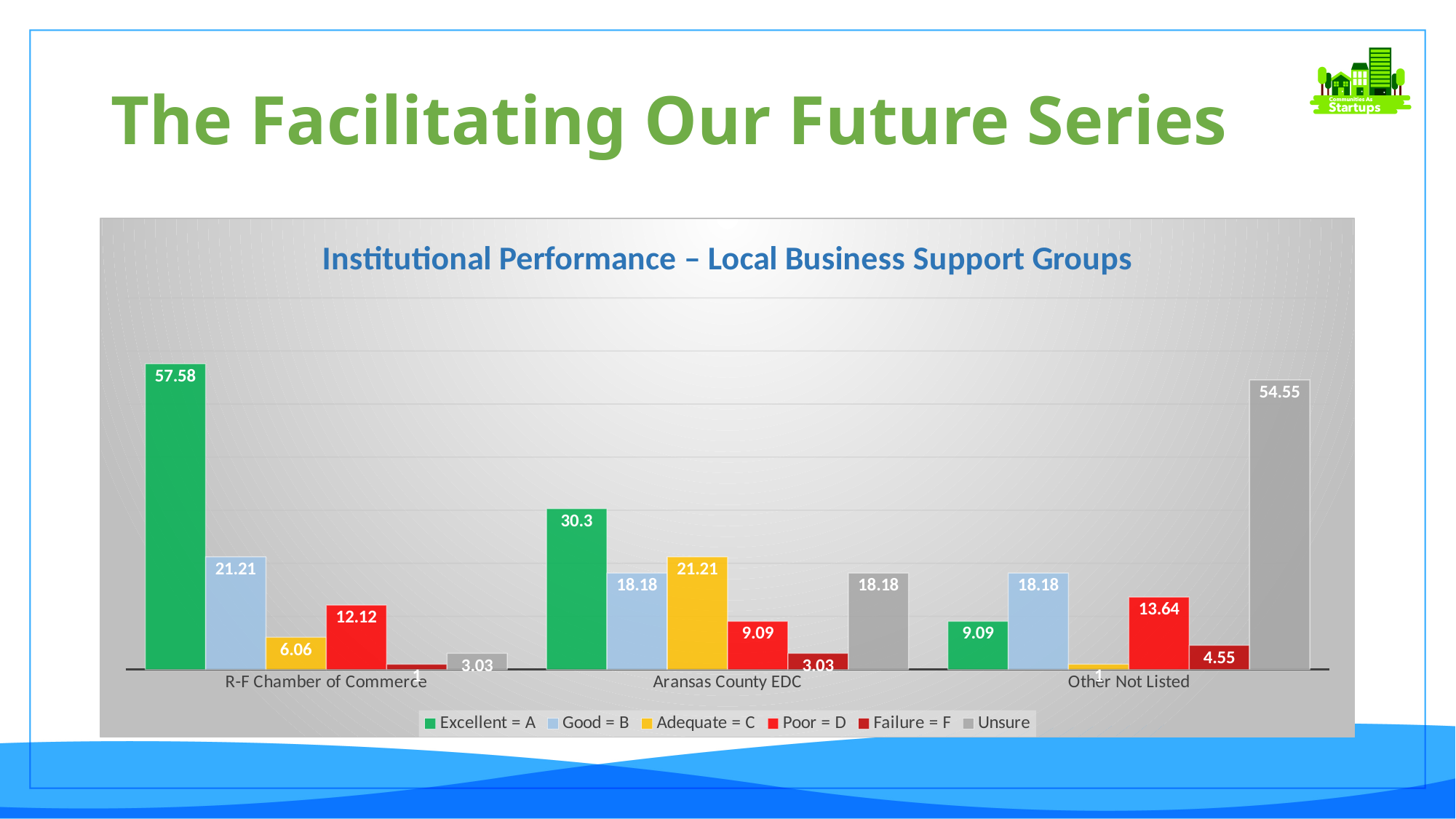
What is the difference between the Excellent = A values for R-F Chamber of Commerce and Aransas County EDC? 27.28 Which is larger for Aransas County EDC: Good = B or Adequate = C? Adequate = C How many categories are shown on the x axis? 3 Which category has the highest Excellent = A value? R-F Chamber of Commerce What is the Adequate = C value for Aransas County EDC? 21.21 What kind of chart is shown on the slide? Bar chart Which category has the lowest Unsure value? R-F Chamber of Commerce How many series does the legend list? 6 What is the Excellent = A value for R-F Chamber of Commerce? 57.58 What is the Poor = D value for Other Not Listed? 13.64 What is the title of the chart? Institutional Performance – Local Business Support Groups What is the Unsure value for Other Not Listed? 54.55